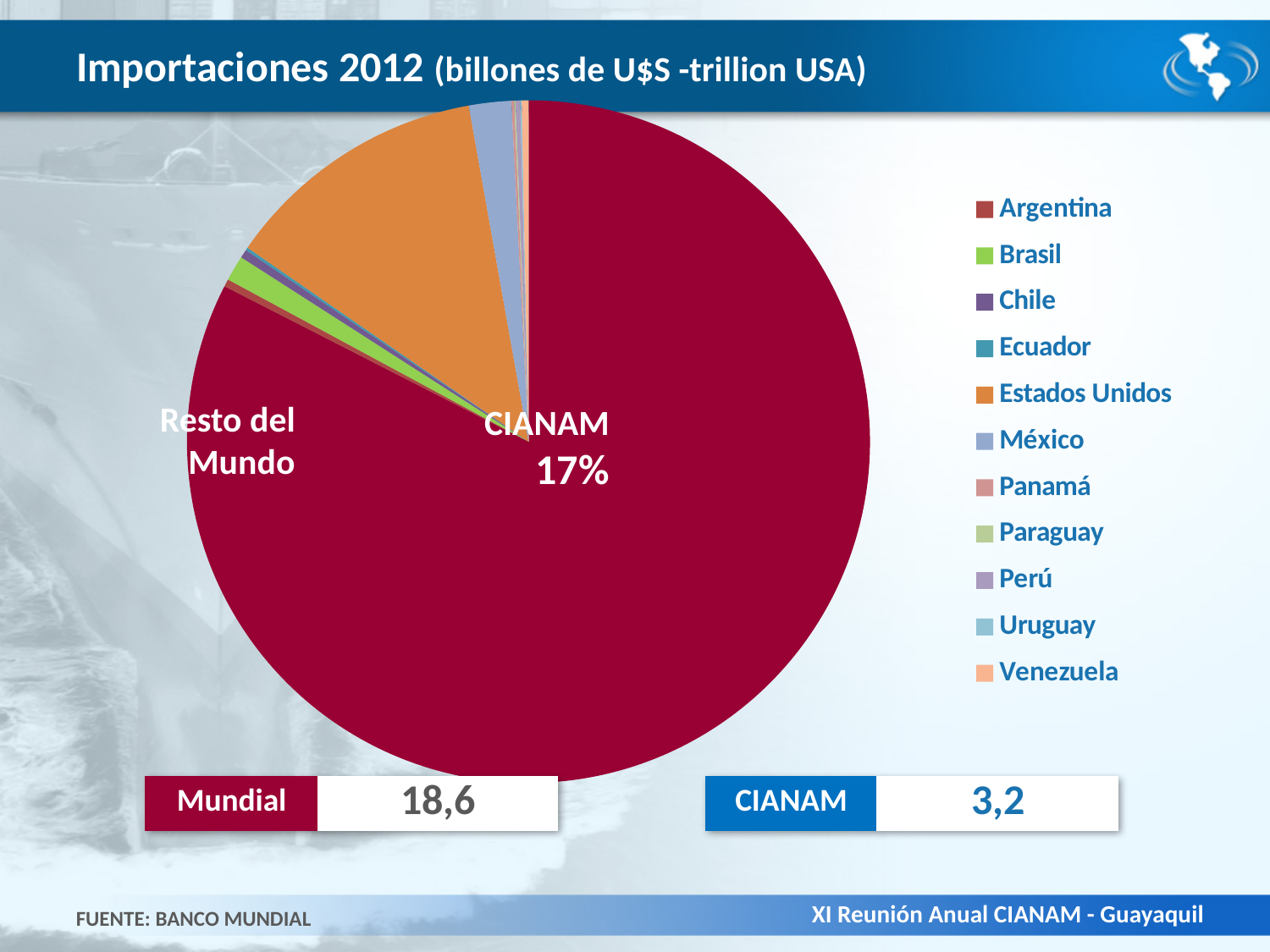
What value is shown for CIANAM in the box below the chart? 3,2 How many entries does the legend list? 11 What kind of chart is shown on the slide? pie chart Which slice is larger, México or Brasil? México What value is shown for Mundial in the box below the chart? 18,6 Among the countries listed in the legend, which has the largest slice of the pie? Estados Unidos What share of the pie is labelled for CIANAM? 17% What colour is the Estados Unidos slice in the pie? orange Which slice of the pie is the largest? Resto del Mundo What is the difference between the Mundial value (18,6) and the CIANAM value (3,2)? 15,4 What is the title of the chart? Importaciones 2012 (billones de U$S -trillion USA) Which slice is larger, Estados Unidos or Brasil? Estados Unidos